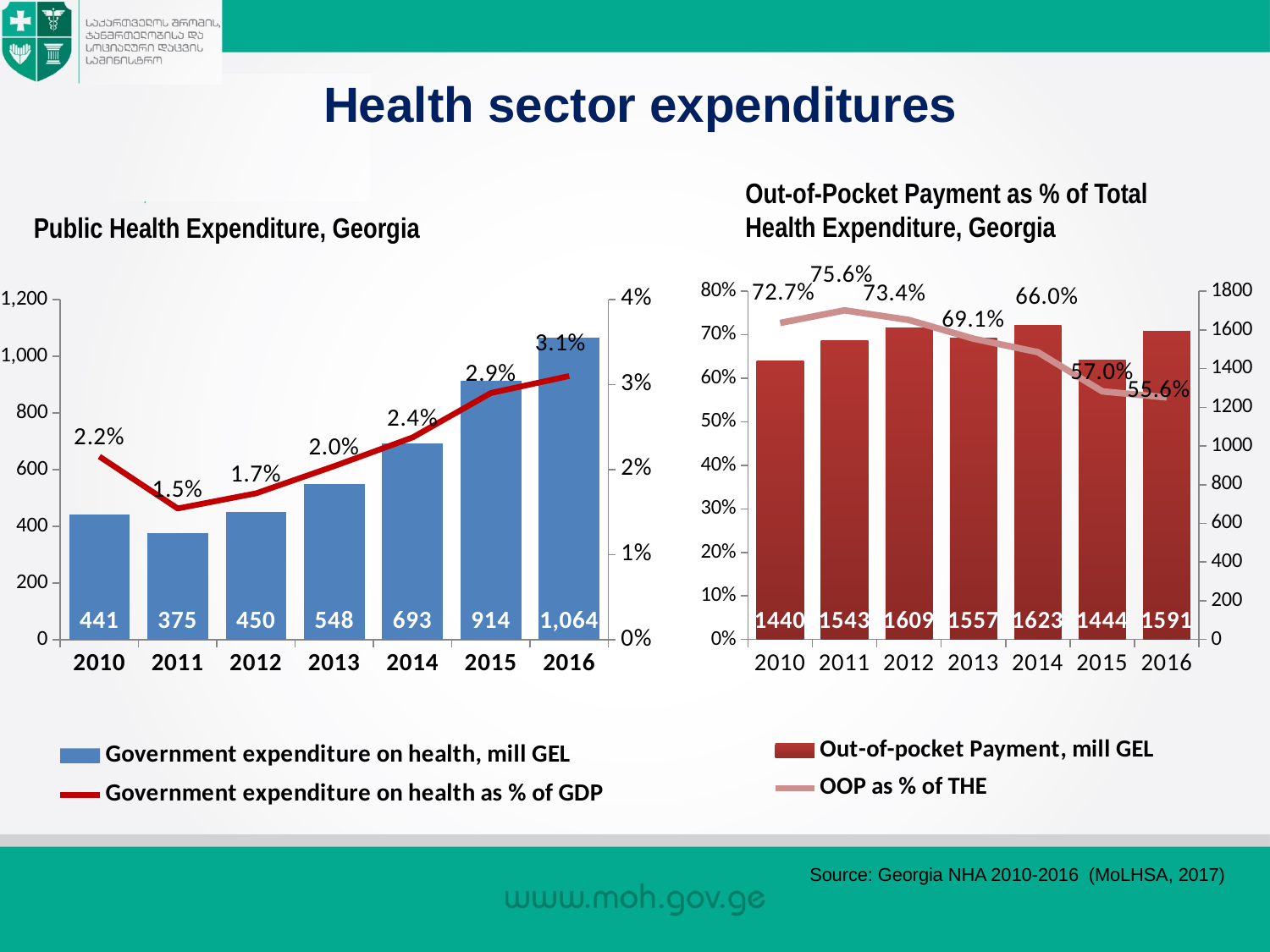
In the 'Public Health Expenditure, Georgia' chart, what was government expenditure on health in mill GEL in 2014? 693 In the 'Public Health Expenditure, Georgia' chart, which year has the highest government expenditure on health in mill GEL? 2016 In the 'Out-of-Pocket Payment as % of Total Health Expenditure, Georgia' chart, what was out-of-pocket payment in mill GEL in 2012? 1609 In the 'Out-of-Pocket Payment as % of Total Health Expenditure, Georgia' chart, what was OOP as % of THE in 2016? 55.6% In the 'Public Health Expenditure, Georgia' chart, does government expenditure on health as % of GDP rise or fall from 2012 to 2016? rise In the 'Public Health Expenditure, Georgia' chart, which year has the lowest government expenditure on health in mill GEL? 2011 In the 'Public Health Expenditure, Georgia' chart, what is the difference in government expenditure on health (mill GEL) between 2016 and 2015? 150 In the 'Out-of-Pocket Payment as % of Total Health Expenditure, Georgia' chart, which year has the highest OOP as % of THE? 2011 How many years are shown on the x axis of the 'Public Health Expenditure, Georgia' chart? 7 In the 'Public Health Expenditure, Georgia' chart, what was government expenditure on health as % of GDP in 2011? 1.5% How many series does the legend of the 'Out-of-Pocket Payment as % of Total Health Expenditure, Georgia' chart list? 2 In the 'Out-of-Pocket Payment as % of Total Health Expenditure, Georgia' chart, which is larger: out-of-pocket payment in mill GEL in 2014 or in 2015? 2014